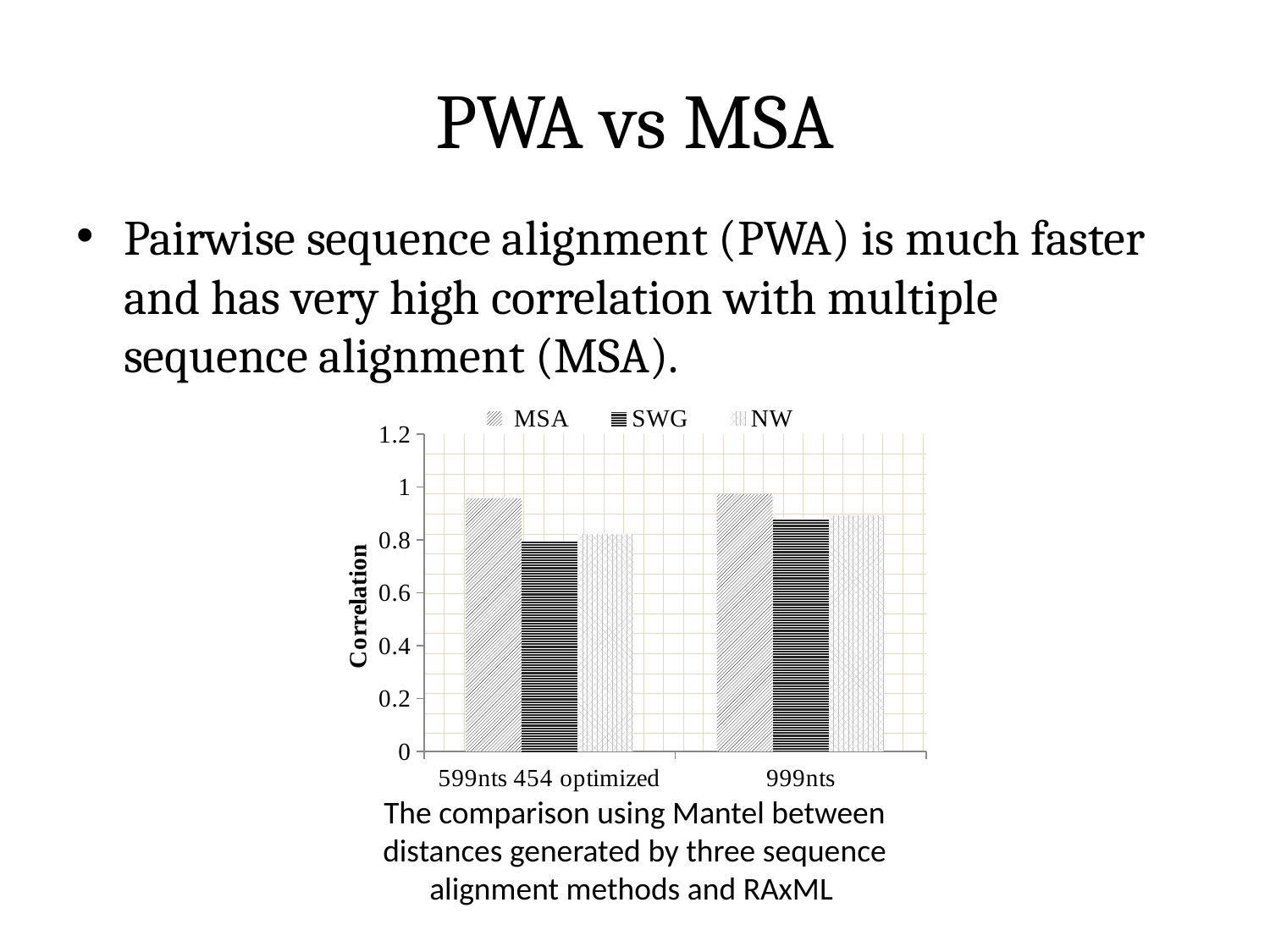
Is the SWG correlation larger for 599nts 454 optimized or for 999nts? 999nts What kind of chart is shown on the slide? bar chart How many series does the chart legend list? 3 Which series are listed in the chart legend? MSA, SWG, NW Does the NW correlation rise or fall from 599nts 454 optimized to 999nts? rise Which series has the highest correlation for the 999nts category? MSA Is the SWG value for 999nts greater or less than 0.8? greater What is the label of the y axis of the chart? Correlation Which series has the lowest correlation for the 599nts 454 optimized category? SWG How many categories are shown on the x axis of the chart? 2 Which series has the highest correlation for the 599nts 454 optimized category? MSA Is the MSA value for 599nts 454 optimized greater or less than 0.8? greater